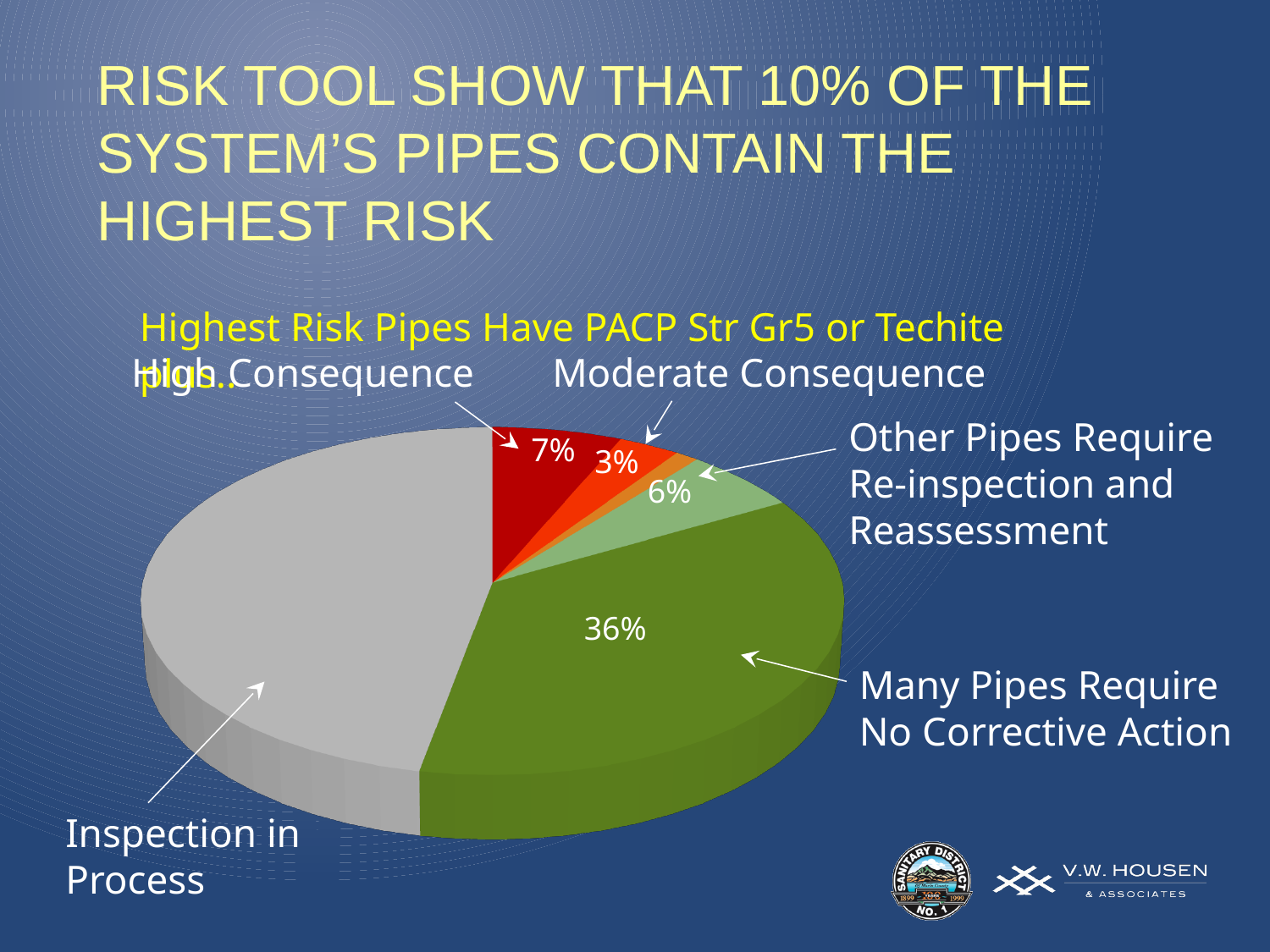
What is the difference in percentage points between the Many Pipes Require No Corrective Action slice (36%) and the Other Pipes Require Re-inspection and Reassessment slice (6%)? 30 What is the title of the slide containing the pie chart? RISK TOOL SHOW THAT 10% OF THE SYSTEM'S PIPES CONTAIN THE HIGHEST RISK Which is larger, the Many Pipes Require No Corrective Action slice or the High Consequence slice? Many Pipes Require No Corrective Action What colour is the Inspection in Process slice? gray Which slice of the pie is the largest? Inspection in Process What is the difference in percentage points between the High Consequence slice (7%) and the Moderate Consequence slice (3%)? 4 What percentage is shown for the slice labelled Many Pipes Require No Corrective Action? 36% What percentage is shown for the High Consequence slice? 7% What percentage is shown for the Moderate Consequence slice? 3% What percentage is shown for the slice labelled Other Pipes Require Re-inspection and Reassessment? 6% Which is larger, the High Consequence slice or the Moderate Consequence slice? High Consequence What kind of chart is shown on the slide? pie chart